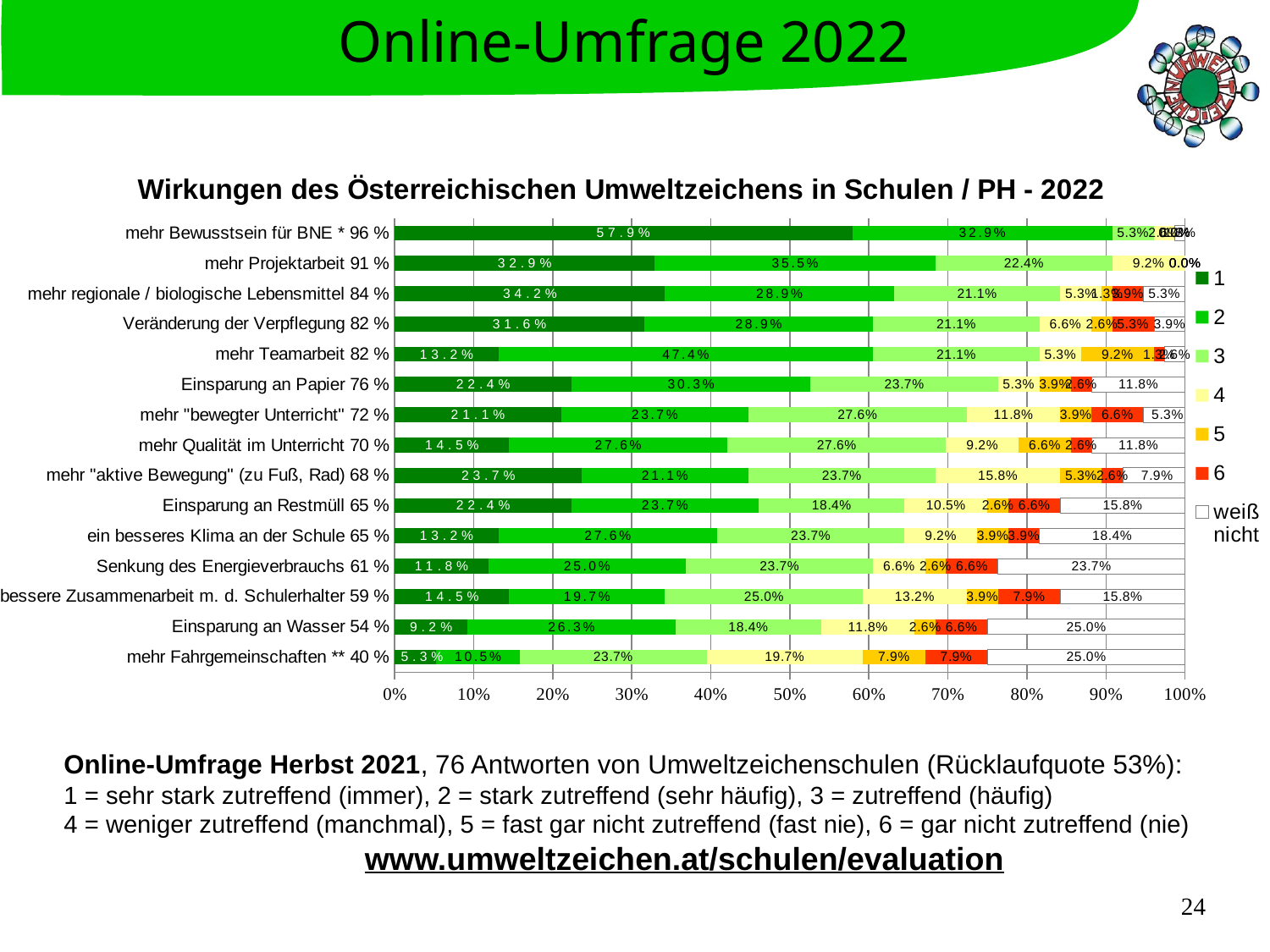
Which is larger: the series 2 value for "mehr Teamarbeit 82 %" or the series 2 value for "Einsparung an Papier 76 %"? mehr Teamarbeit 82 % What is the value of series 2 for "mehr Teamarbeit 82 %"? 47.4% What is the total of the stacked bar for "Senkung des Energieverbrauchs 61 %"? 100.0% What is the title of the chart? Wirkungen des Österreichischen Umweltzeichens in Schulen / PH - 2022 What is the value of series 1 for "mehr Bewusstsein für BNE * 96 %"? 57.9% What is the "weiß nicht" value for "Einsparung an Wasser 54 %"? 25.0% What is the difference between the series 1 values for "mehr Bewusstsein für BNE * 96 %" and "mehr Projektarbeit 91 %"? 25.0 percentage points How many categories (rows) does the chart show? 15 How many series does the legend list? 7 Which category has the highest value for series 1? mehr Bewusstsein für BNE * 96 % What kind of chart is shown on the slide? Stacked bar chart Which category has the lowest value for series 1? mehr Fahrgemeinschaften ** 40 %